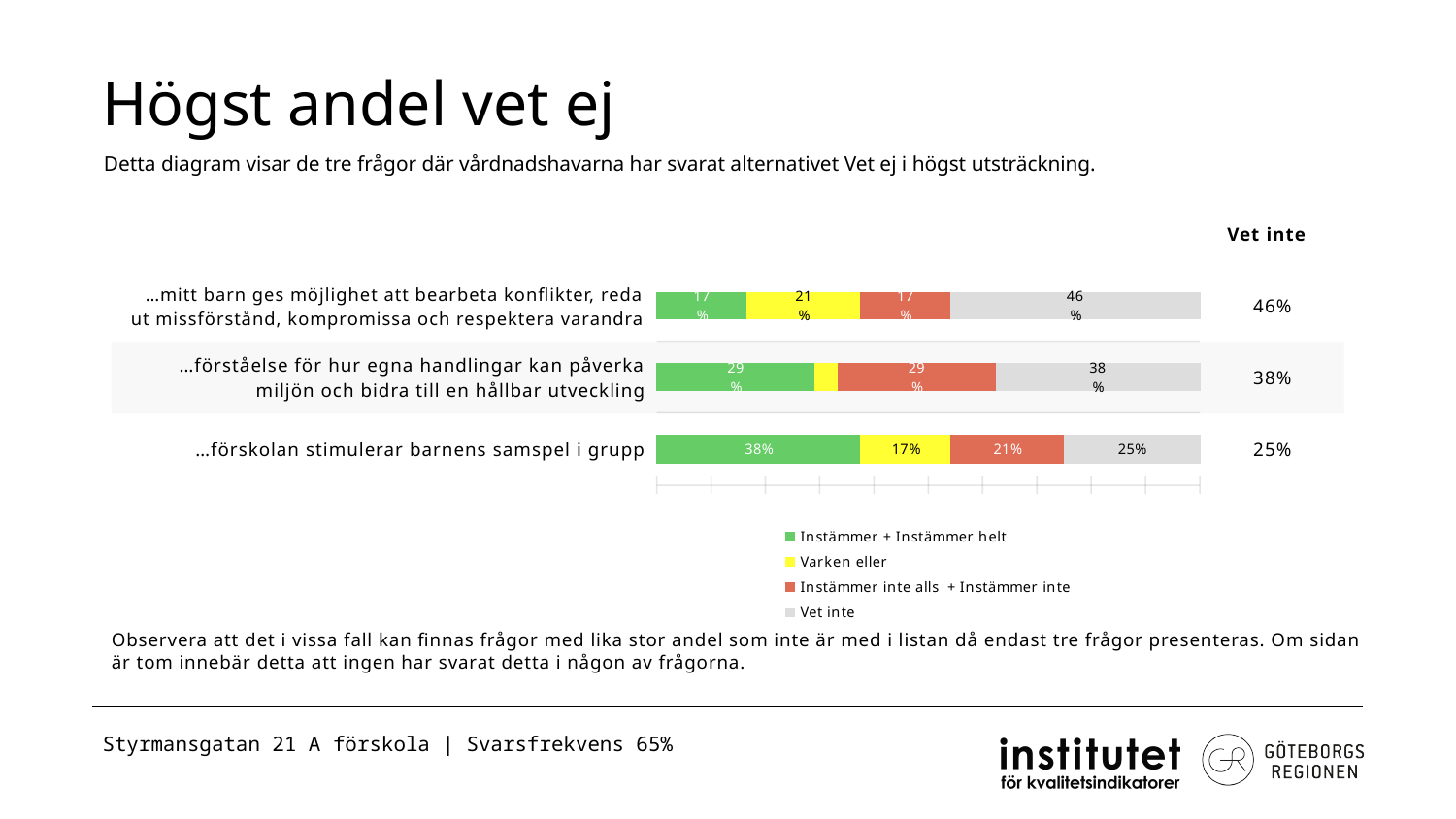
What is the 'Instämmer + Instämmer helt' value for '…förskolan stimulerar barnens samspel i grupp'? 38% How many categories (questions) are plotted in the chart? 3 Which category has the lowest 'Vet inte' share? …förskolan stimulerar barnens samspel i grupp What kind of chart is shown on the slide? Stacked bar chart What is the 'Vet inte' value for '…mitt barn ges möjlighet att bearbeta konflikter, reda ut missförstånd, kompromissa och respektera varandra'? 46% What is the 'Vet inte' value for '…förskolan stimulerar barnens samspel i grupp'? 25% Which colour represents 'Vet inte' in the chart? Grey How many series does the legend list? 4 Which is larger: the 'Varken eller' value for '…mitt barn ges möjlighet att bearbeta konflikter…' or for '…förskolan stimulerar barnens samspel i grupp'? …mitt barn ges möjlighet att bearbeta konflikter… Which category has the highest 'Vet inte' share? …mitt barn ges möjlighet att bearbeta konflikter, reda ut missförstånd, kompromissa och respektera varandra What is the difference between the 'Vet inte' values for '…mitt barn ges möjlighet att bearbeta konflikter…' and '…förskolan stimulerar barnens samspel i grupp'? 21% What is the 'Instämmer inte alls + Instämmer inte' value for '…förståelse för hur egna handlingar kan påverka miljön och bidra till en hållbar utveckling'? 29%